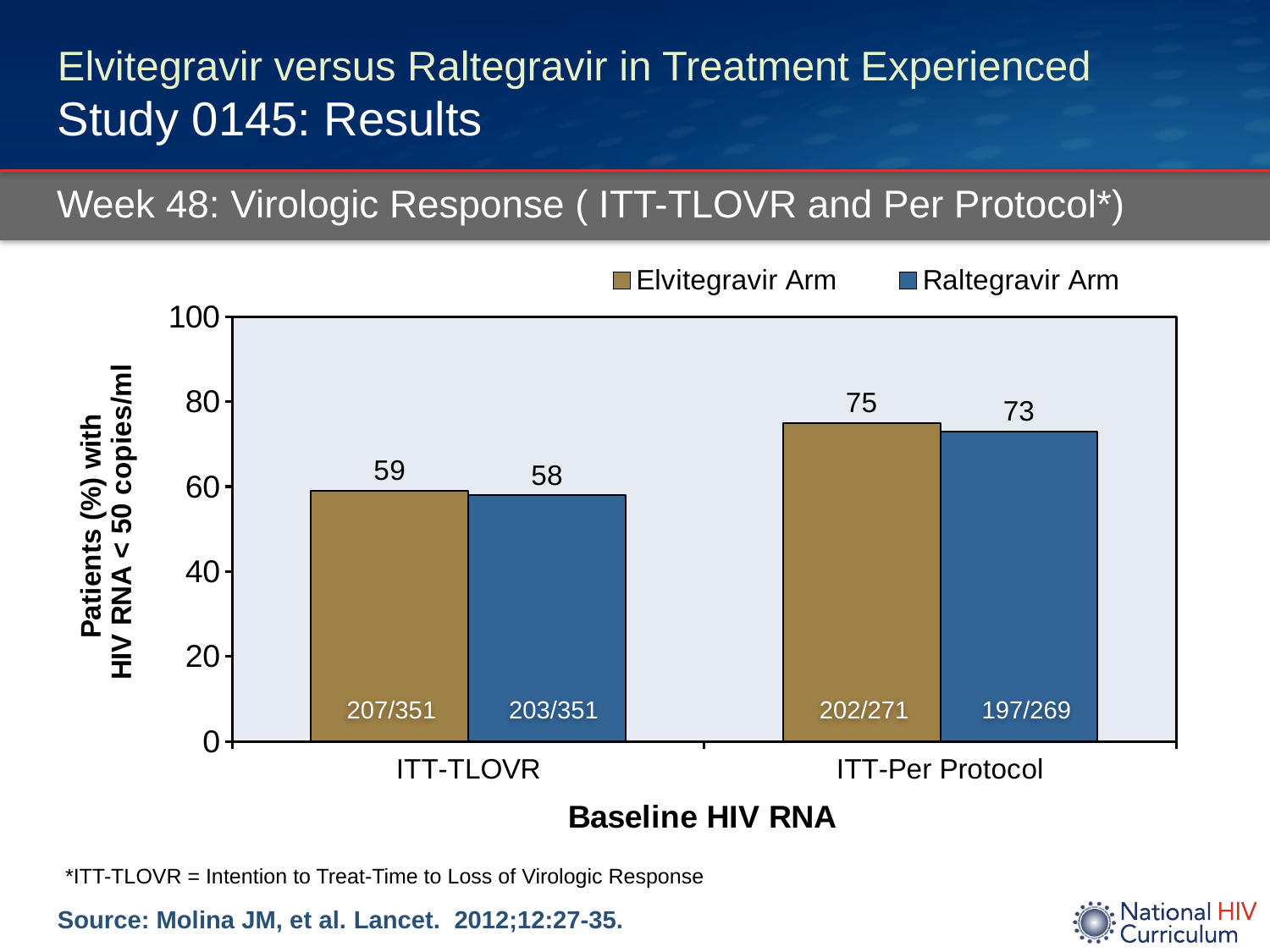
What kind of chart is shown on the slide? Bar chart What is the difference between the Elvitegravir Arm and Raltegravir Arm values in the ITT-Per Protocol category? 2 How many series does the legend list? 2 What is the value for the Raltegravir Arm in the ITT-Per Protocol category? 73 Is the value for the Raltegravir Arm in ITT-TLOVR greater or less than 60? less What fraction is printed inside the Elvitegravir Arm bar for ITT-TLOVR? 207/351 Which bar has the lowest value on the chart? Raltegravir Arm, ITT-TLOVR What is the value for the Elvitegravir Arm in the ITT-TLOVR category? 59 What is the difference between the Elvitegravir Arm values for ITT-Per Protocol and ITT-TLOVR? 16 What is the value for the Raltegravir Arm in the ITT-TLOVR category? 58 Which bar has the highest value on the chart? Elvitegravir Arm, ITT-Per Protocol What is the value for the Elvitegravir Arm in the ITT-Per Protocol category? 75